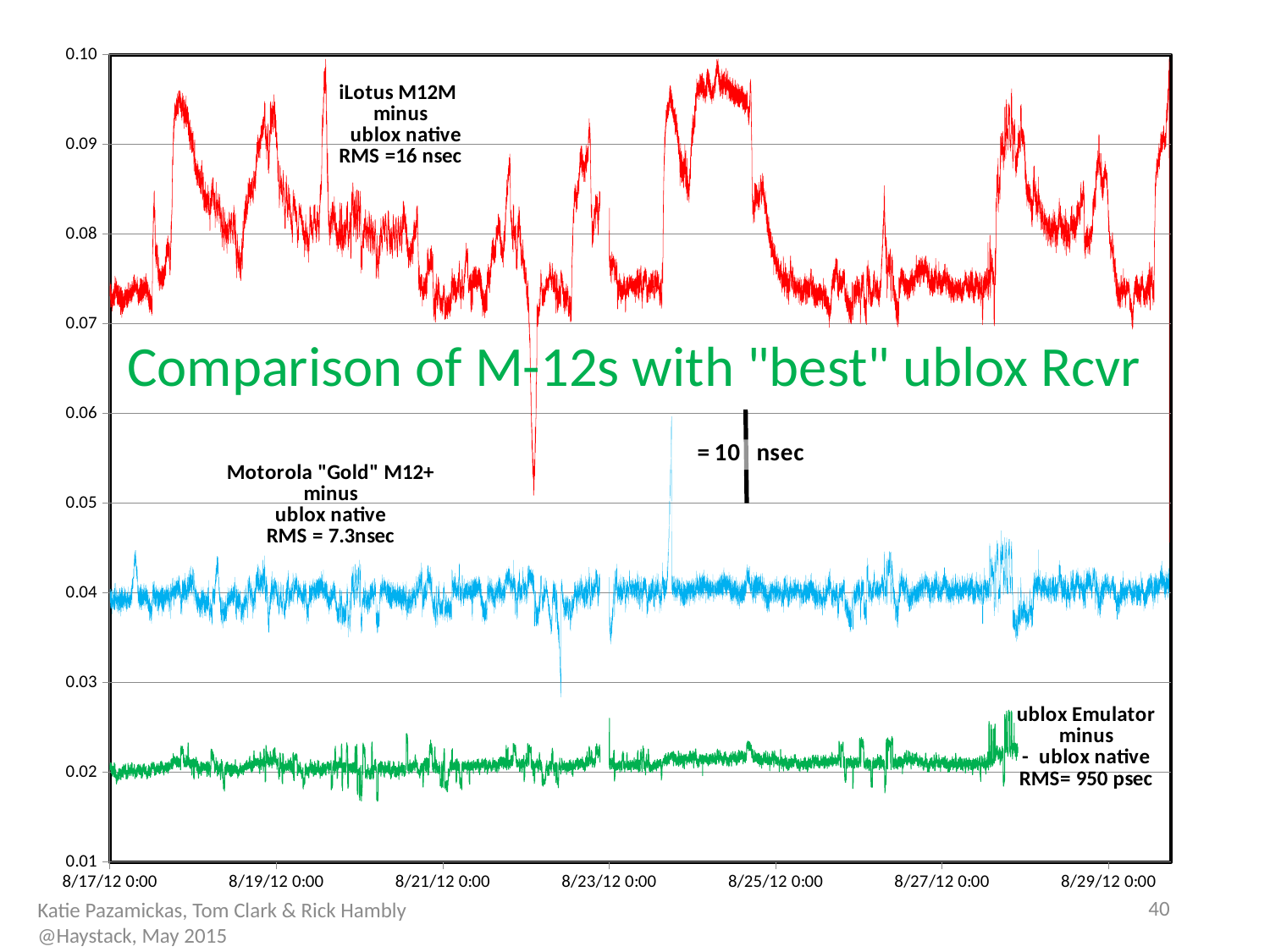
How many data series are plotted on the chart? 3 What is the title of the chart? Comparison of M-12s with "best" ublox Rcvr Which series is plotted higher on the chart, the red iLotus M12M series or the blue Motorola "Gold" M12+ series? red iLotus M12M series Which series has the smallest RMS: iLotus M12M, Motorola "Gold" M12+, or ublox Emulator? ublox Emulator Is the ublox Emulator minus ublox native (green) series plotted mostly greater or less than 0.03 on the y axis? less What is the first date label shown on the x axis? 8/17/12 0:00 What RMS value is given for the ublox Emulator minus ublox native series? 950 psec What RMS value is given for the Motorola "Gold" M12+ minus ublox native series? 7.3nsec Is the iLotus M12M minus ublox native (red) series plotted mostly greater or less than 0.06 on the y axis? greater What kind of chart is shown on the slide? line chart Which series has the largest RMS: iLotus M12M, Motorola "Gold" M12+, or ublox Emulator? iLotus M12M What RMS value is given for the iLotus M12M minus ublox native series? 16 nsec